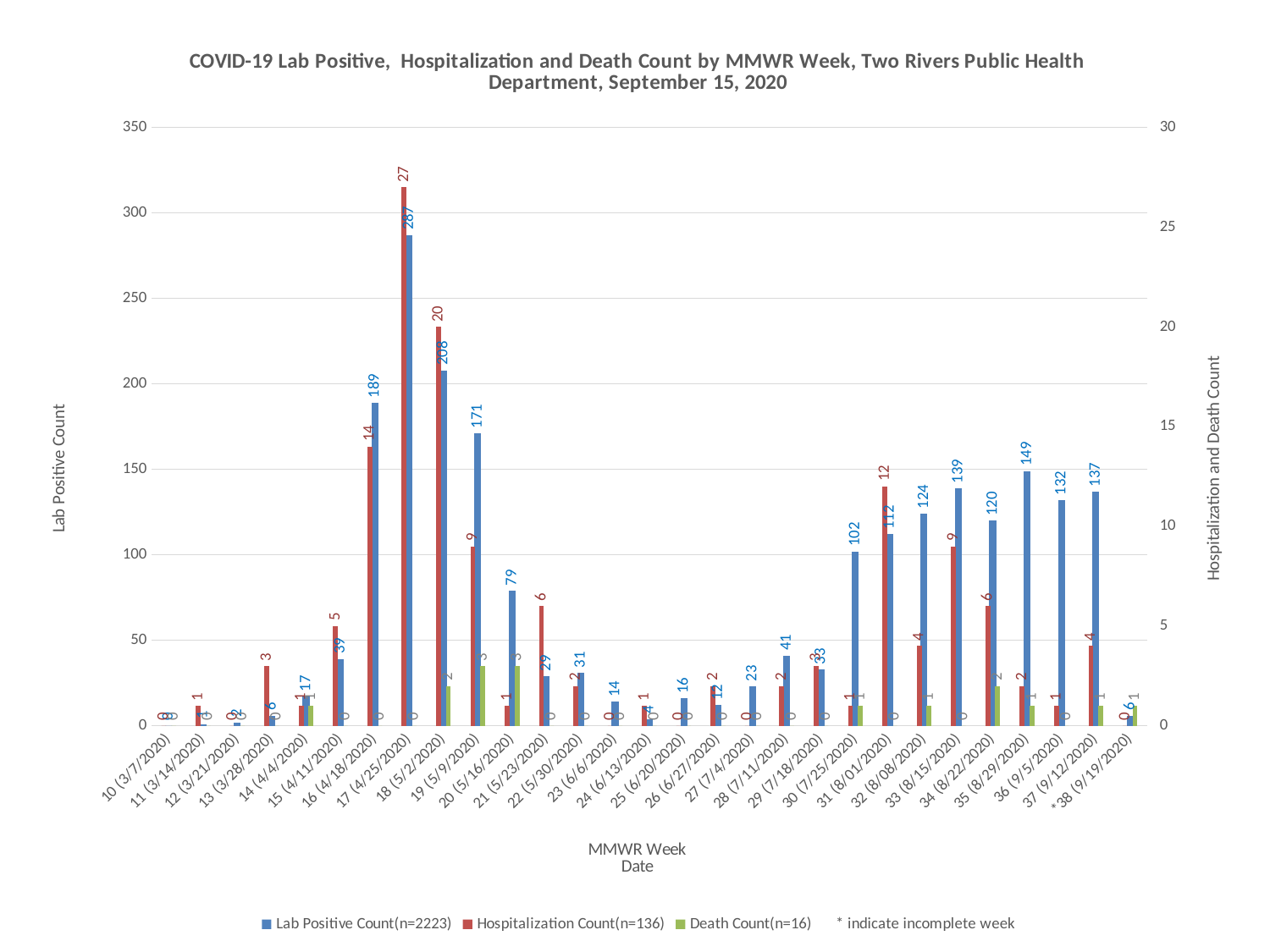
What is the Hospitalization Count for MMWR week 18 (5/2/2020)? 20 What is the Lab Positive Count for MMWR week 35 (8/29/2020)? 149 How many MMWR weeks are shown on the x axis? 29 Which MMWR week has the highest Hospitalization Count? 17 (4/25/2020) Is the Lab Positive Count for week 18 (5/2/2020) greater or less than 200? greater What kind of chart is shown on the slide? Bar chart What is the difference between the Lab Positive Count for week 16 (4/18/2020) and week 19 (5/9/2020)? 18 Which MMWR week has the highest Lab Positive Count? 17 (4/25/2020) What is the Lab Positive Count for MMWR week 17 (4/25/2020)? 287 How many series does the legend list? 3 What does the asterisk (*) on the last x-axis label indicate, according to the legend note? Incomplete week Which is larger, the Lab Positive Count for week 33 (8/15/2020) or for week 36 (9/5/2020)? Week 33 (8/15/2020)